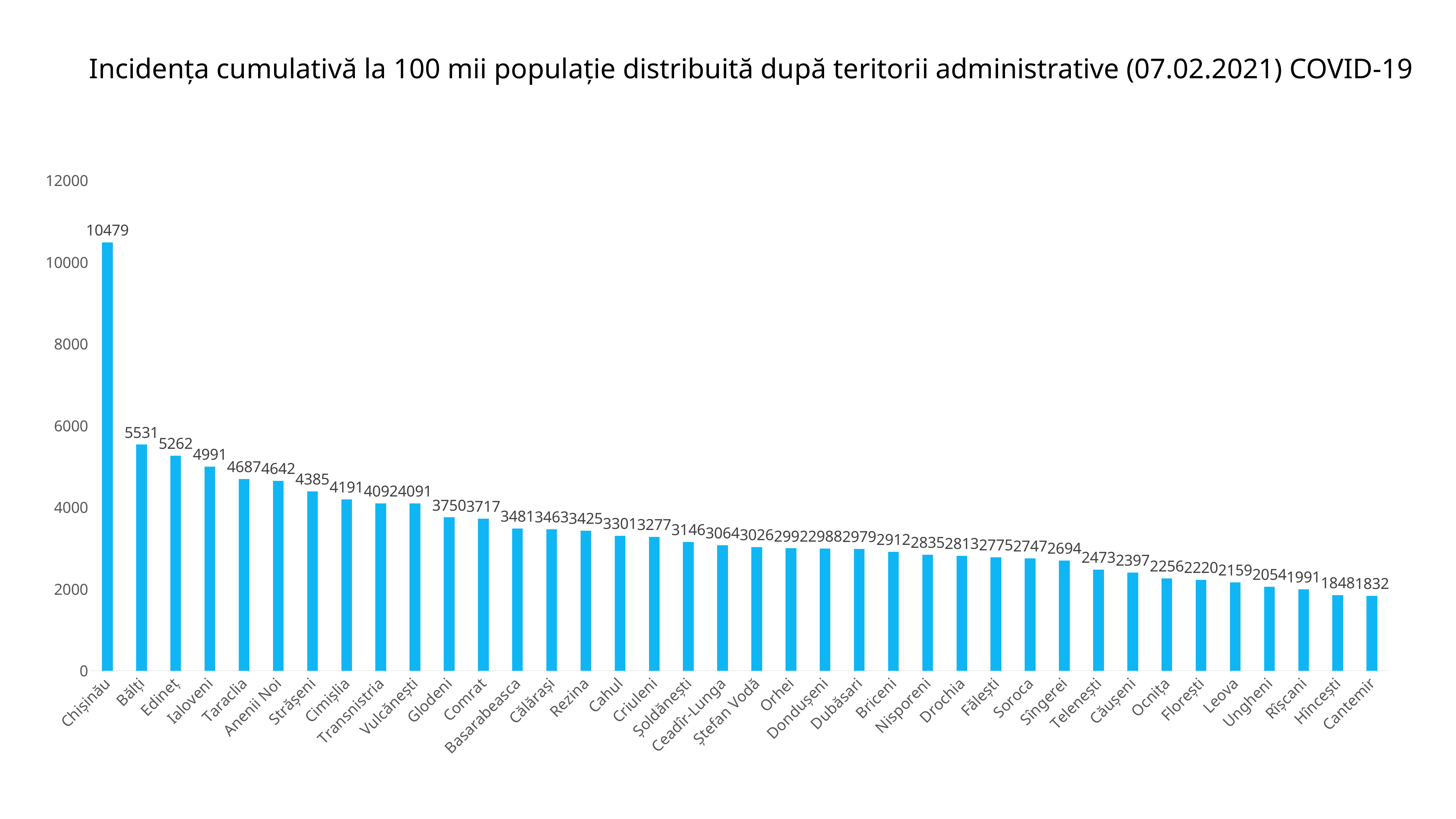
Which territory has the lowest value? Cantemir Do the values rise or fall from left to right along the x axis? fall What is the value for Cahul? 3301 What is the value for Chișinău? 10479 What is the difference between the values for Chișinău and Bălți? 4948 Which territory has the highest value? Chișinău Is the value for Strășeni greater or less than 4000? greater Which has a larger value, Edineț or Ialoveni? Edineț What is the value for Bălți? 5531 How many territories are shown on the x axis? 38 What is the value for Cantemir? 1832 What kind of chart is this? bar chart